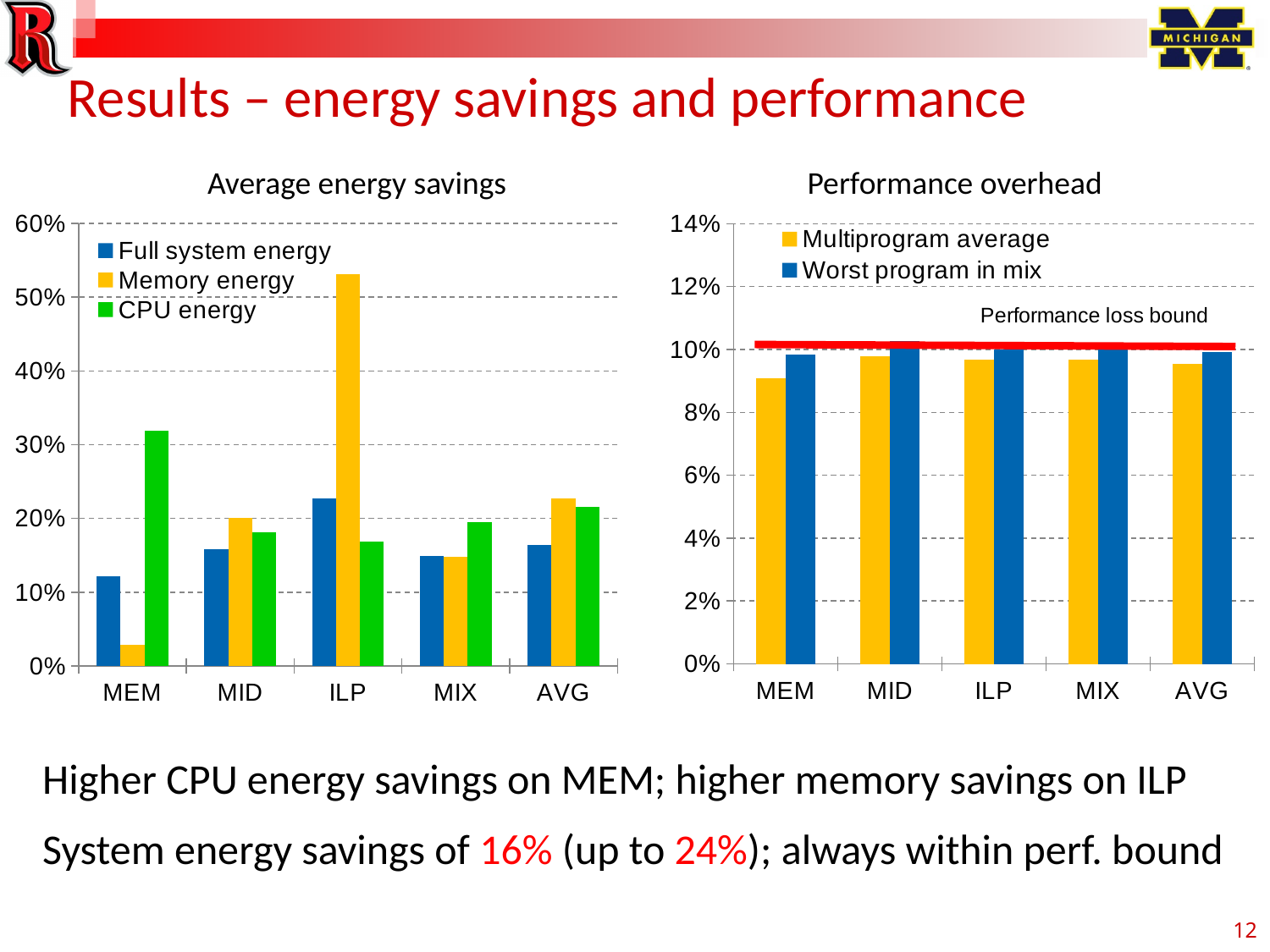
In the "Average energy savings" chart, which category has the lowest Memory energy savings? MEM How many series does the legend of the "Performance overhead" chart list? 2 What kind of chart is the "Average energy savings" chart? bar chart In the "Average energy savings" chart, is the Memory energy value for ILP greater or less than 50%? greater How many series does the legend of the "Average energy savings" chart list? 3 In the "Average energy savings" chart, which category has the highest CPU energy savings? MEM How many categories are shown on the x axis of the "Average energy savings" chart? 5 In the "Performance overhead" chart, for MEM, which is larger: Multiprogram average or Worst program in mix? Worst program in mix In the "Average energy savings" chart, for MEM, which is larger: CPU energy or Full system energy? CPU energy In the "Performance overhead" chart, what does the red horizontal line represent? Performance loss bound In the "Average energy savings" chart, which category has the highest Memory energy savings? ILP In the "Performance overhead" chart, is the Multiprogram average value for MEM greater or less than 10%? less